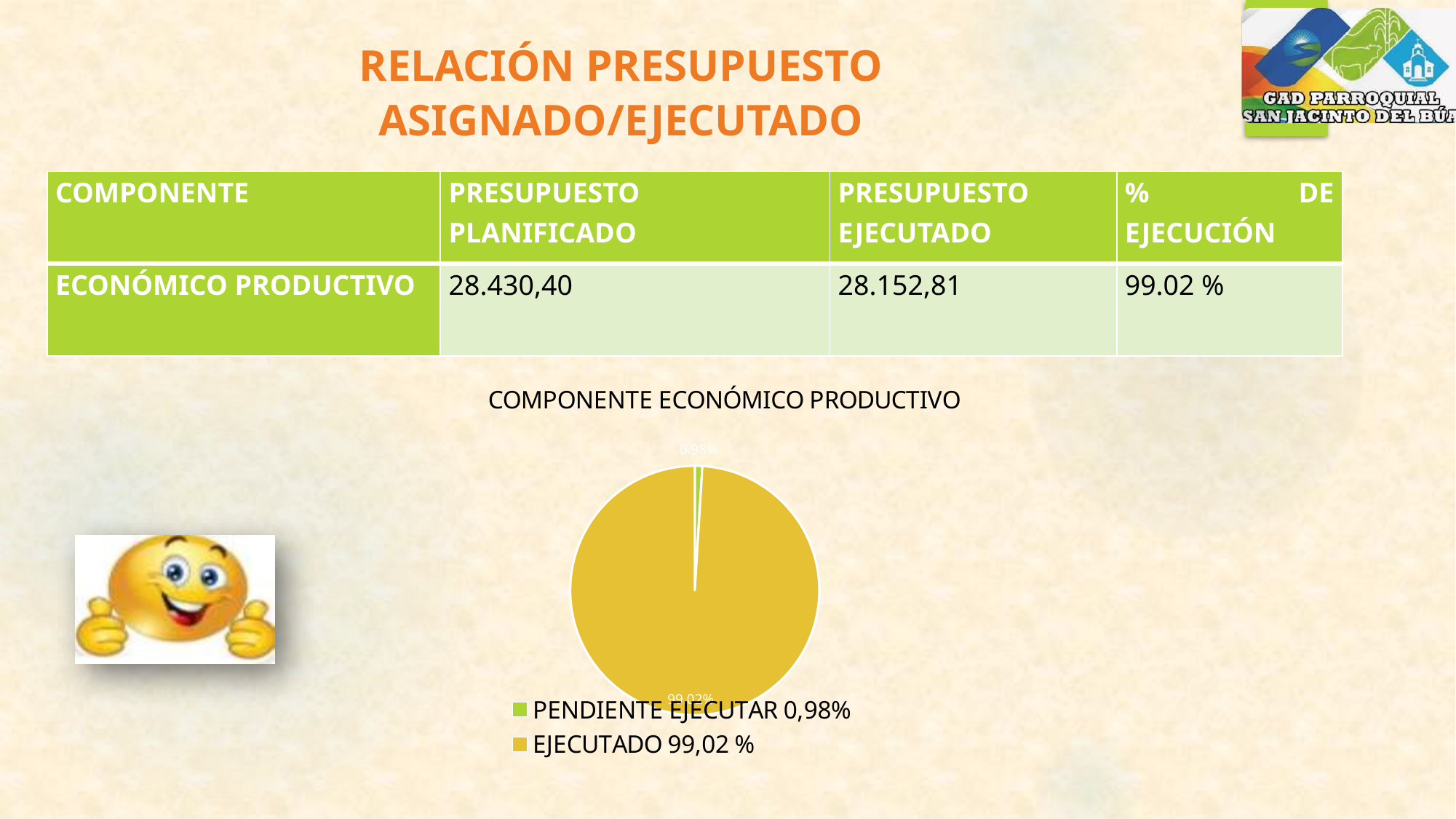
Which is larger, the EJECUTADO slice or the PENDIENTE EJECUTAR slice? EJECUTADO What colour is the EJECUTADO slice in the pie chart? gold What is the difference in percentage points between the EJECUTADO and PENDIENTE EJECUTAR slices? 98,04 What kind of chart is shown on the slide? pie chart How many entries does the chart legend list? 2 How many slices does the pie chart have? 2 Which slice of the pie chart is the largest? EJECUTADO What is the title of the chart? COMPONENTE ECONÓMICO PRODUCTIVO What share of the pie does the PENDIENTE EJECUTAR slice represent? 0,98% What share of the pie does the EJECUTADO slice represent? 99,02% Which slice of the pie chart is the smallest? PENDIENTE EJECUTAR